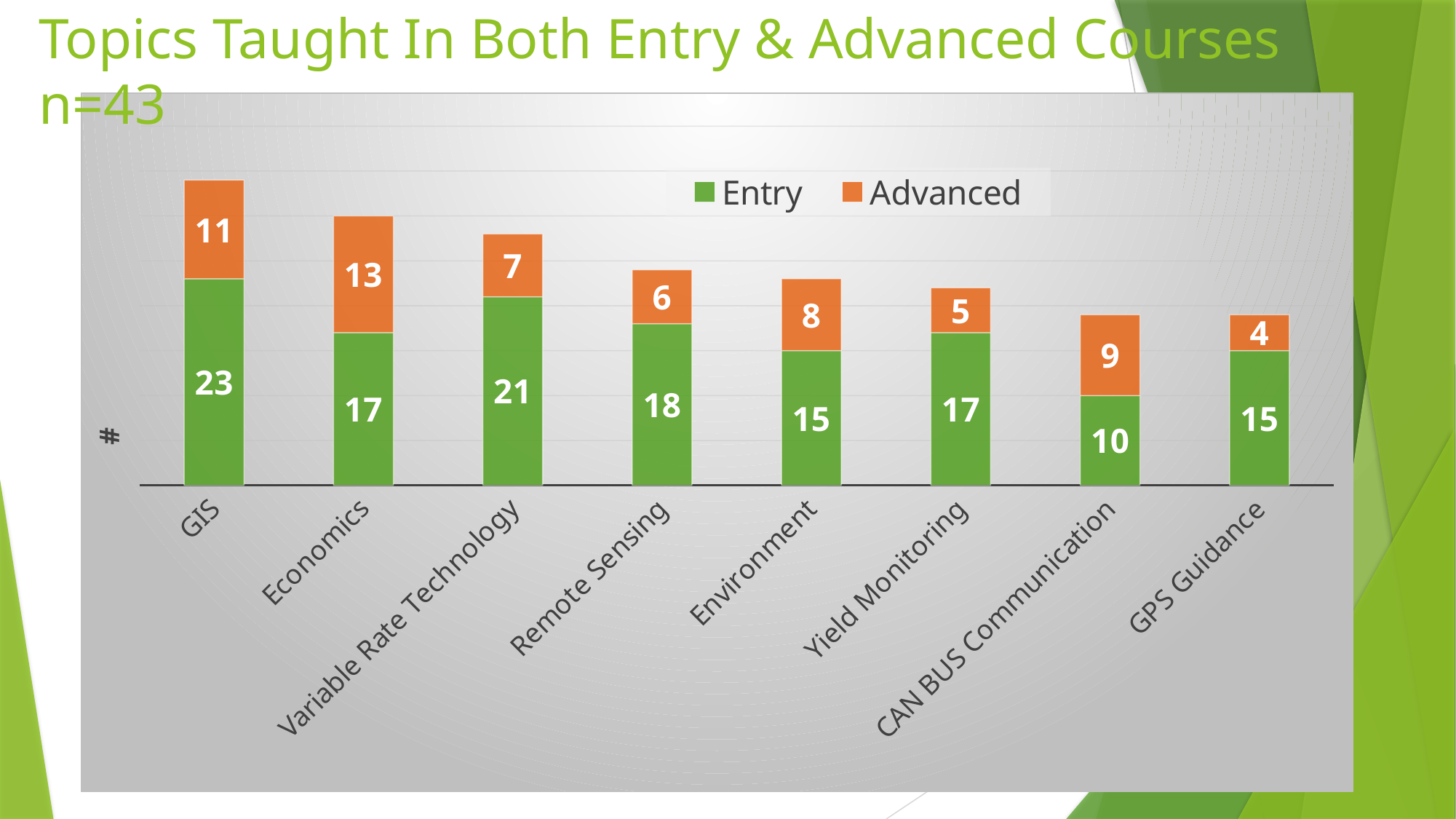
Which colour represents the Advanced series in the legend? Orange How many series does the legend list? 2 What kind of chart is shown on the slide? Stacked bar chart What is the difference between the Entry and Advanced values for Variable Rate Technology? 14 What is the Advanced value for Economics? 13 What is the Entry value for GIS? 23 Which category has the lowest Advanced value? GPS Guidance Which is larger, the Advanced value for Environment or the Advanced value for Remote Sensing? Environment Which category has the highest Entry value? GIS How many categories are shown on the x axis? 8 What is the Entry value for CAN BUS Communication? 10 What is the total of the stacked bar for Yield Monitoring? 22